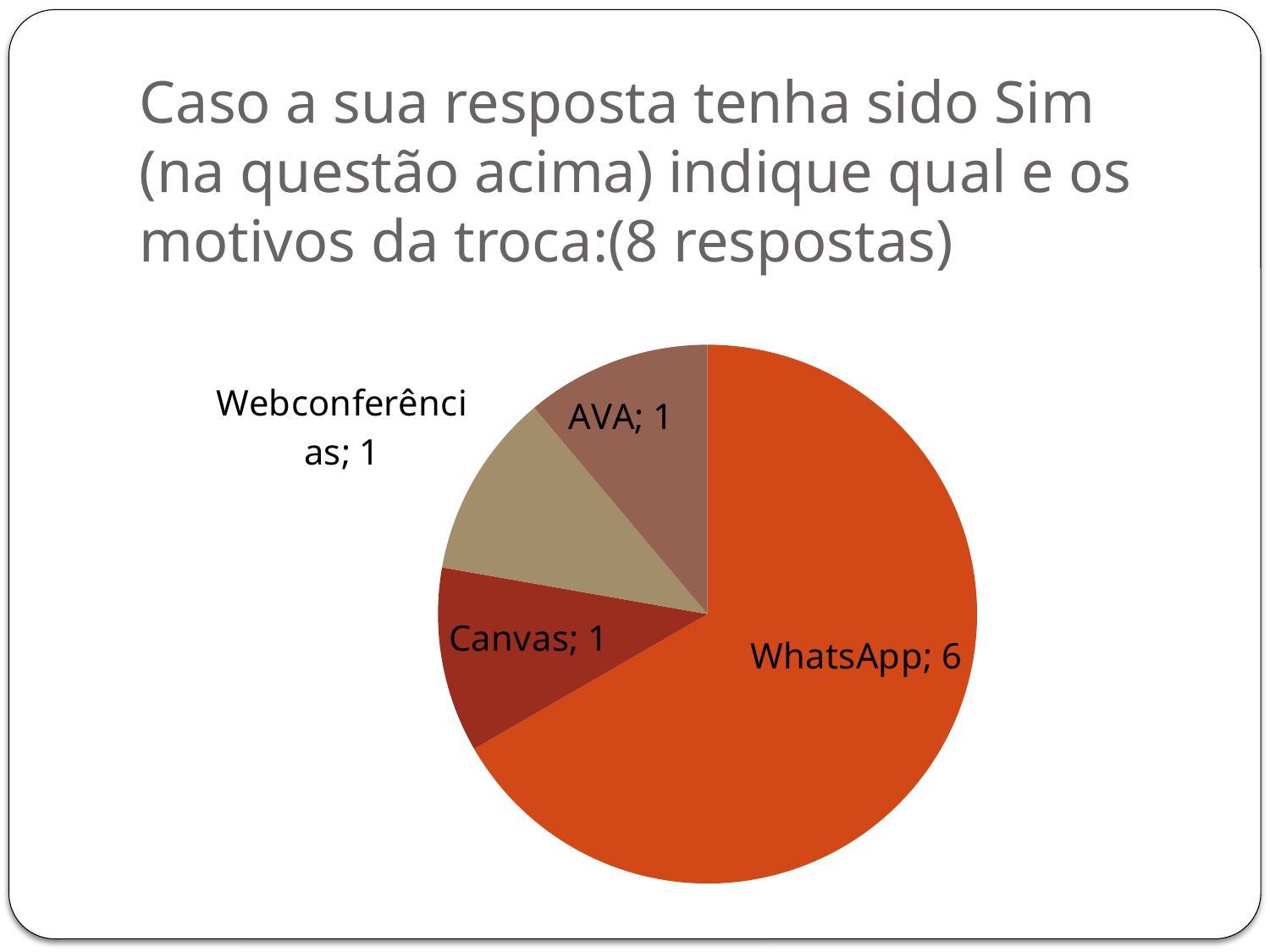
What is the total of all the slice values shown in the pie chart? 9 What is the value for AVA? 1 What is the difference between the values for WhatsApp and Canvas? 5 What is the value for Webconferências? 1 What is the value for Canvas? 1 What type of chart is shown on the slide? Pie chart Which category has the largest slice of the pie? WhatsApp What is the value for WhatsApp? 6 How many responses does the slide title say the question received? 8 respostas How many slices does the pie chart have? 4 What fraction of the total plotted values does the WhatsApp slice represent? 6 out of 9 (two thirds) Which is larger, the value for WhatsApp or the value for AVA? WhatsApp